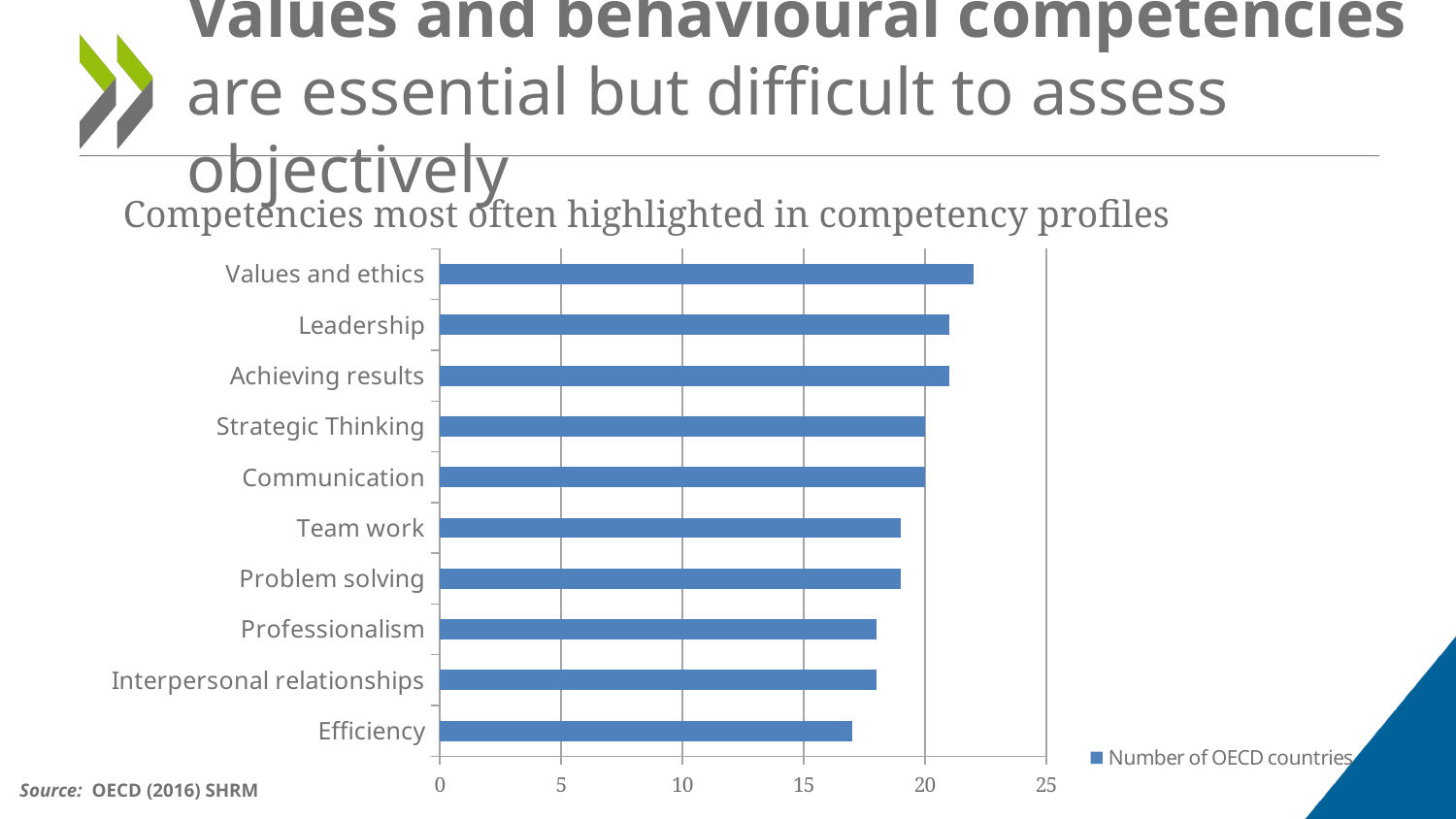
Is the value for Values and ethics greater or less than 20? greater Which competency has the lowest number of OECD countries? Efficiency What is the title of the chart? Competencies most often highlighted in competency profiles How many series does the legend list? 1 What series name does the legend show? Number of OECD countries How many competencies are listed on the chart? 10 Which is larger, the value for Values and ethics or the value for Efficiency? Values and ethics Is the value for Efficiency greater or less than 15? greater Which competency has the highest number of OECD countries? Values and ethics What kind of chart is shown on the slide? Bar chart Is the value for Team work greater or less than 20? less